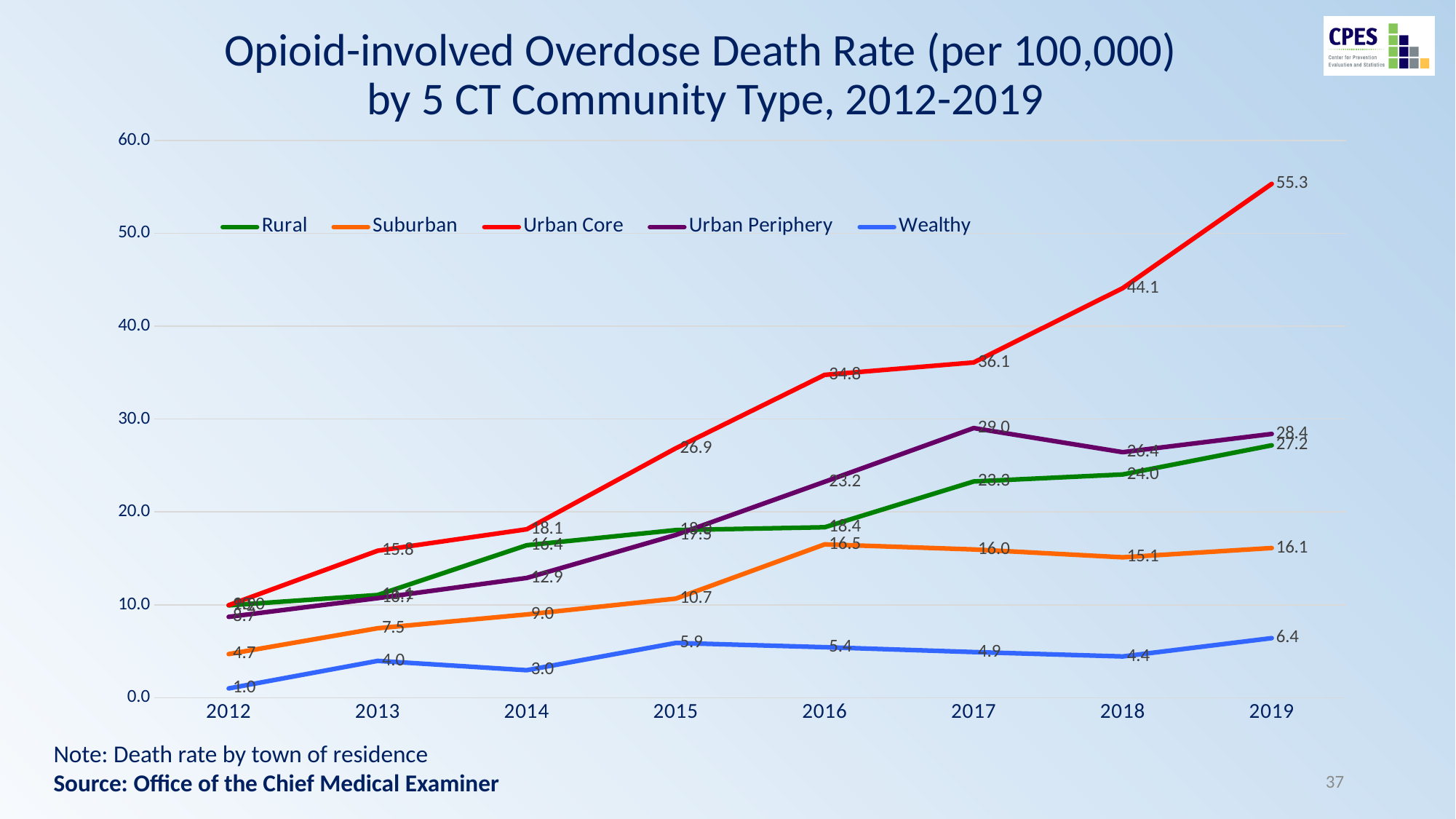
What is the death rate for Suburban communities in 2016? 16.5 By how much did the Urban Core death rate increase from 2018 to 2019? 11.2 Is the Urban Core death rate in 2018 greater or less than 40.0? greater Which community type has the highest death rate in 2019? Urban Core How many years are shown on the x axis? 8 What is the death rate for Urban Periphery in 2017? 29.0 What kind of chart is shown on the slide? line chart In 2019, which has the higher death rate: Rural or Urban Periphery? Urban Periphery What is the death rate for Wealthy communities in 2012? 1.0 Which community type has the lowest death rate in 2019? Wealthy What is the opioid-involved overdose death rate for Urban Core in 2019? 55.3 How many community types does the legend list? 5